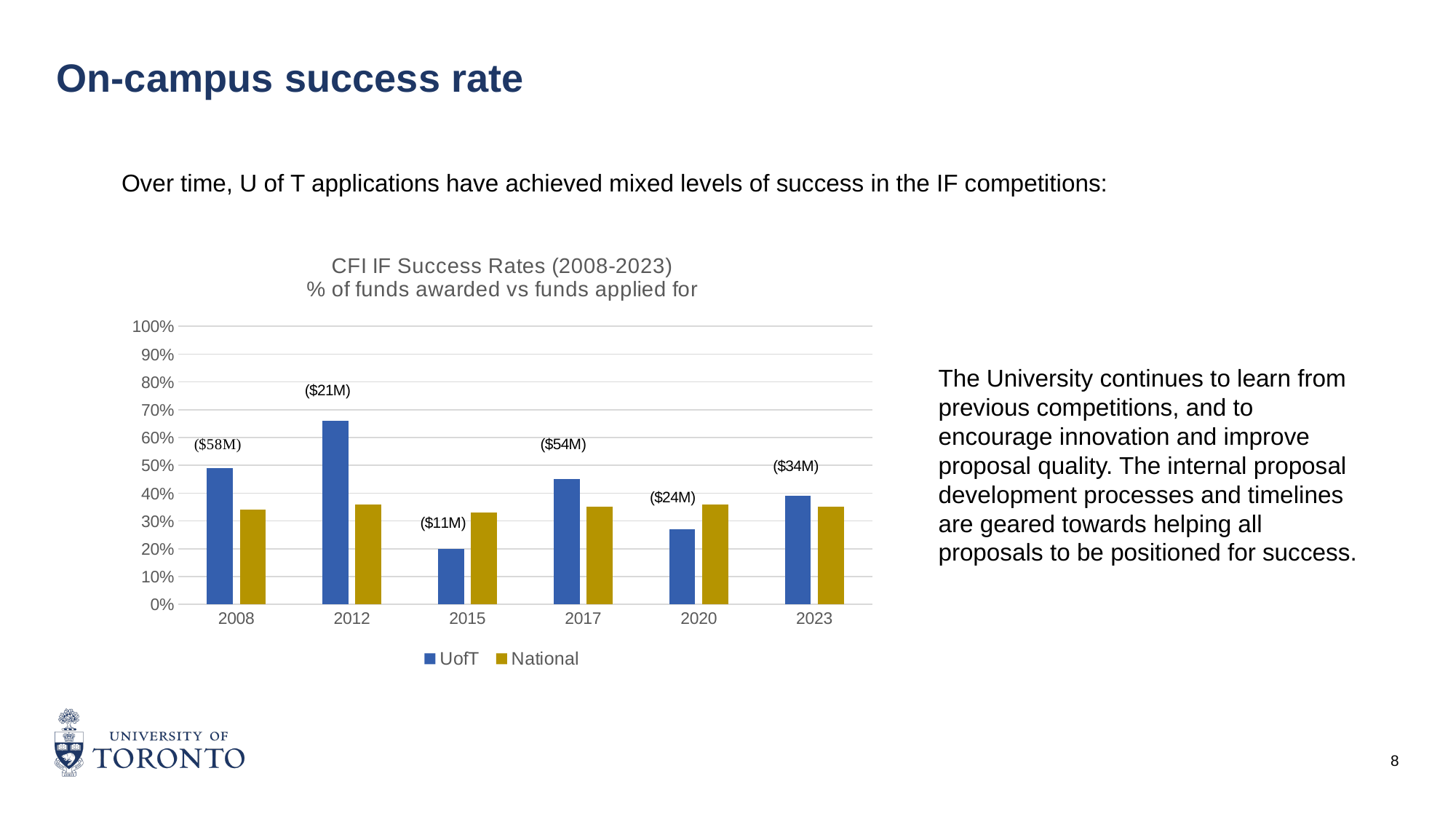
In 2012, which is larger, the UofT or the National success rate? UofT Is the UofT success rate for 2015 greater or less than 30%? less Is the UofT success rate for 2012 greater or less than 60%? greater What is the title of the chart? CFI IF Success Rates (2008-2023) % of funds awarded vs funds applied for What dollar amount is labelled above the 2012 bars? ($21M) In which year is the UofT success rate highest? 2012 How many years are shown on the x axis of the chart? 6 How many series does the chart legend list? 2 What type of chart is shown on the slide? Bar chart Is the UofT success rate for 2017 greater or less than 40%? greater In which year is the UofT success rate lowest? 2015 In 2015, which is larger, the UofT or the National success rate? National